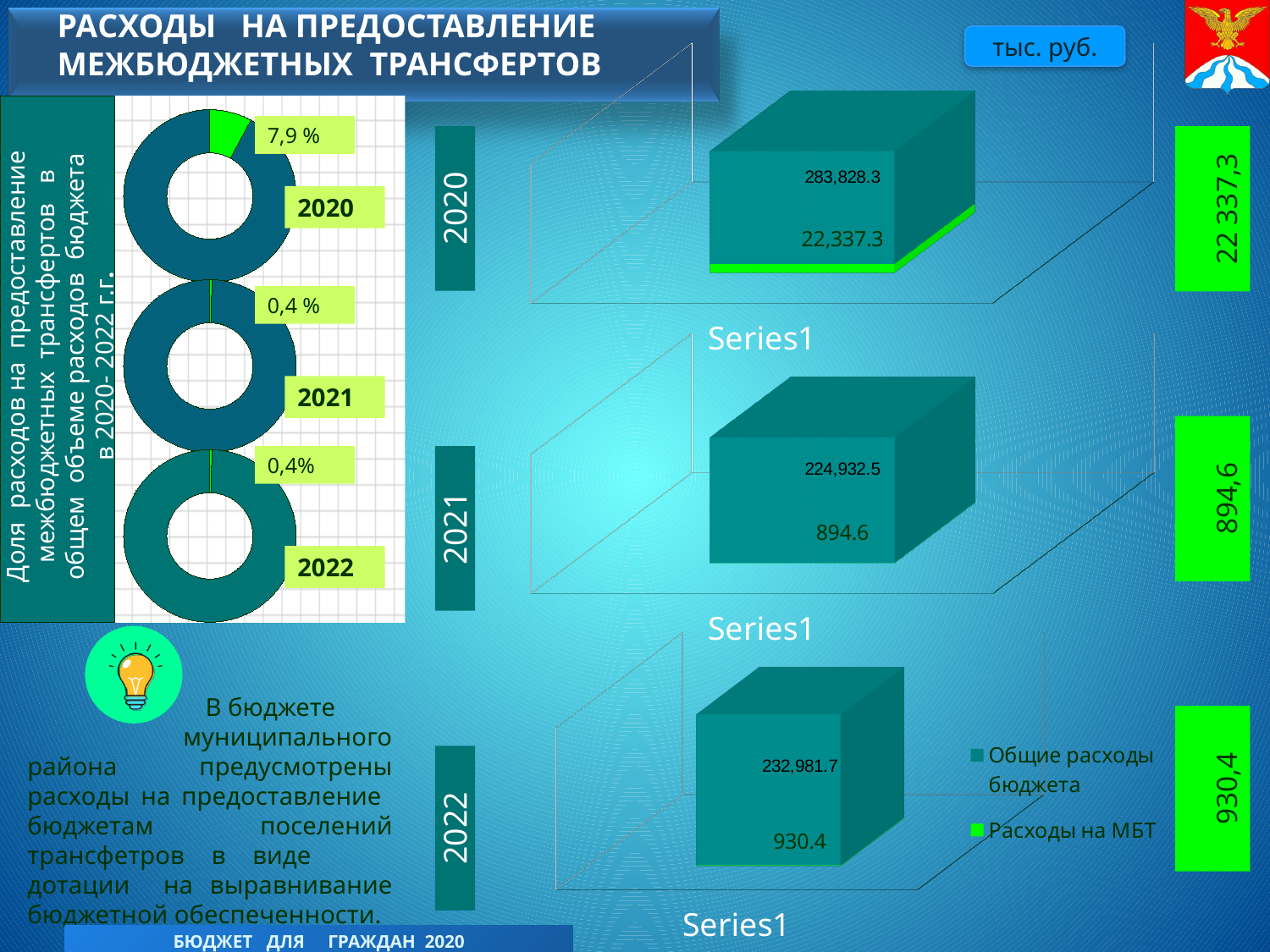
In the 2020 bar chart, what is the value labelled for Расходы на МБТ? 22,337.3 In the 2022 bar chart, which is larger: Общие расходы бюджета or Расходы на МБТ? Общие расходы бюджета How many series does the legend of the bar charts list? 2 In the 2021 bar chart, what is the value labelled for Общие расходы бюджета? 224,932.5 In the 2021 donut chart on the left, what percentage is labelled? 0,4 % In the 2022 bar chart, what is the value labelled for Общие расходы бюджета? 232,981.7 In the 2020 donut chart on the left, what share is shown for the green slice? 7,9 % What kind of chart is used for the 2020, 2021 and 2022 charts in the middle of the slide? Bar chart In the 2022 bar chart, what is the value labelled for Расходы на МБТ? 930.4 In the 2020 bar chart, what is the value labelled for Общие расходы бюджета? 283,828.3 Which year's bar chart shows the highest value for Расходы на МБТ: 2020, 2021 or 2022? 2020 In the 2021 bar chart, what is the value labelled for Расходы на МБТ? 894.6